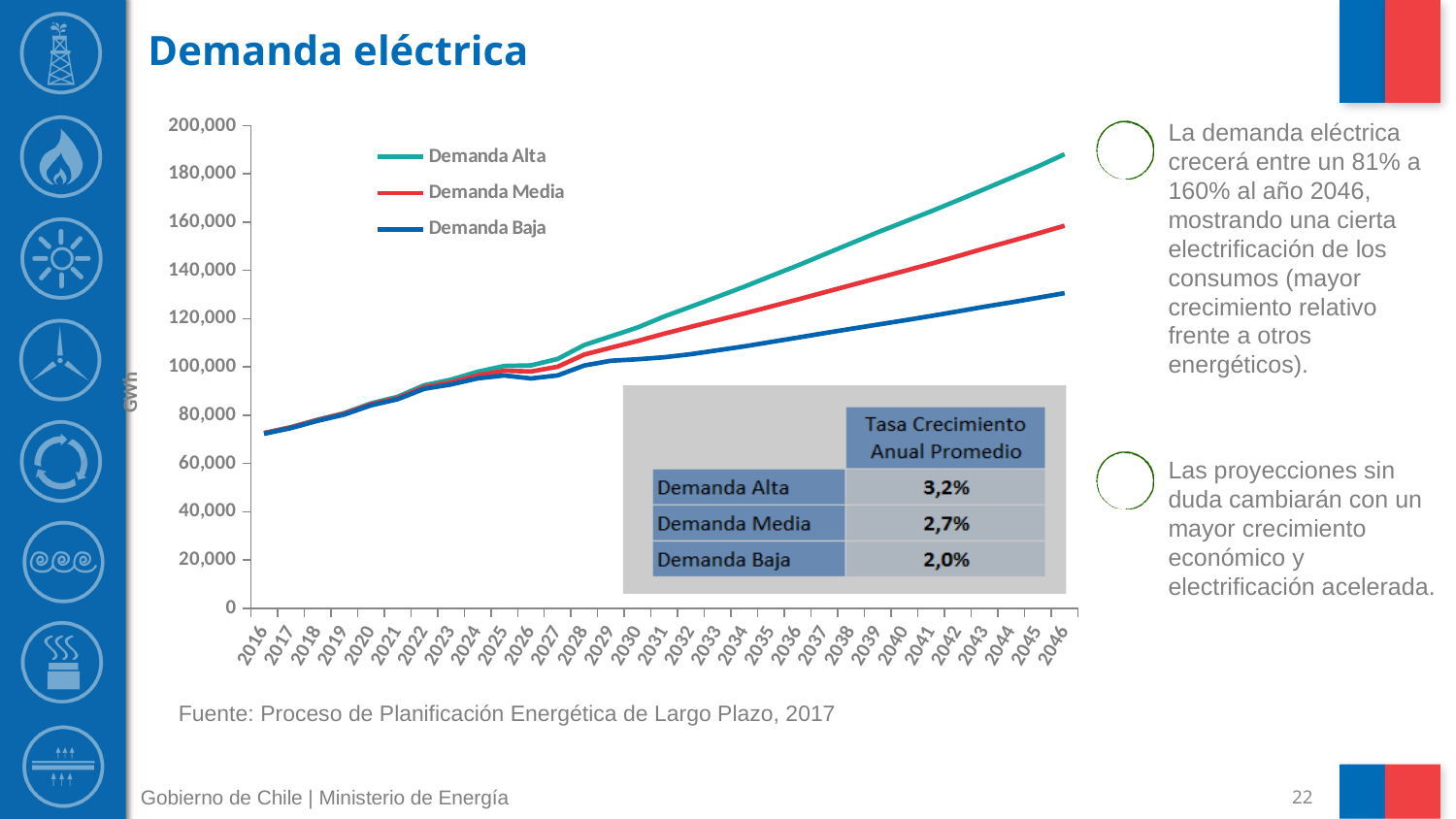
According to the table in the chart, what is the Tasa Crecimiento Anual Promedio for Demanda Baja? 2,0% Is the value for Demanda Alta in 2046 greater or less than 180,000? greater According to the table in the chart, what is the Tasa Crecimiento Anual Promedio for Demanda Alta? 3,2% Is the value for Demanda Baja in 2046 greater or less than 140,000? less Is the value for Demanda Media in 2046 greater or less than 140,000? greater Which series has the lowest value in 2046? Demanda Baja Which series has the highest value in 2046? Demanda Alta What colour is the Demanda Media line in the chart? Red How many years are shown on the x axis of the chart? 31 How many series does the legend list? 3 What kind of chart is shown on the slide? Line chart Do the values of Demanda Media rise or fall from 2016 to 2046? Rise